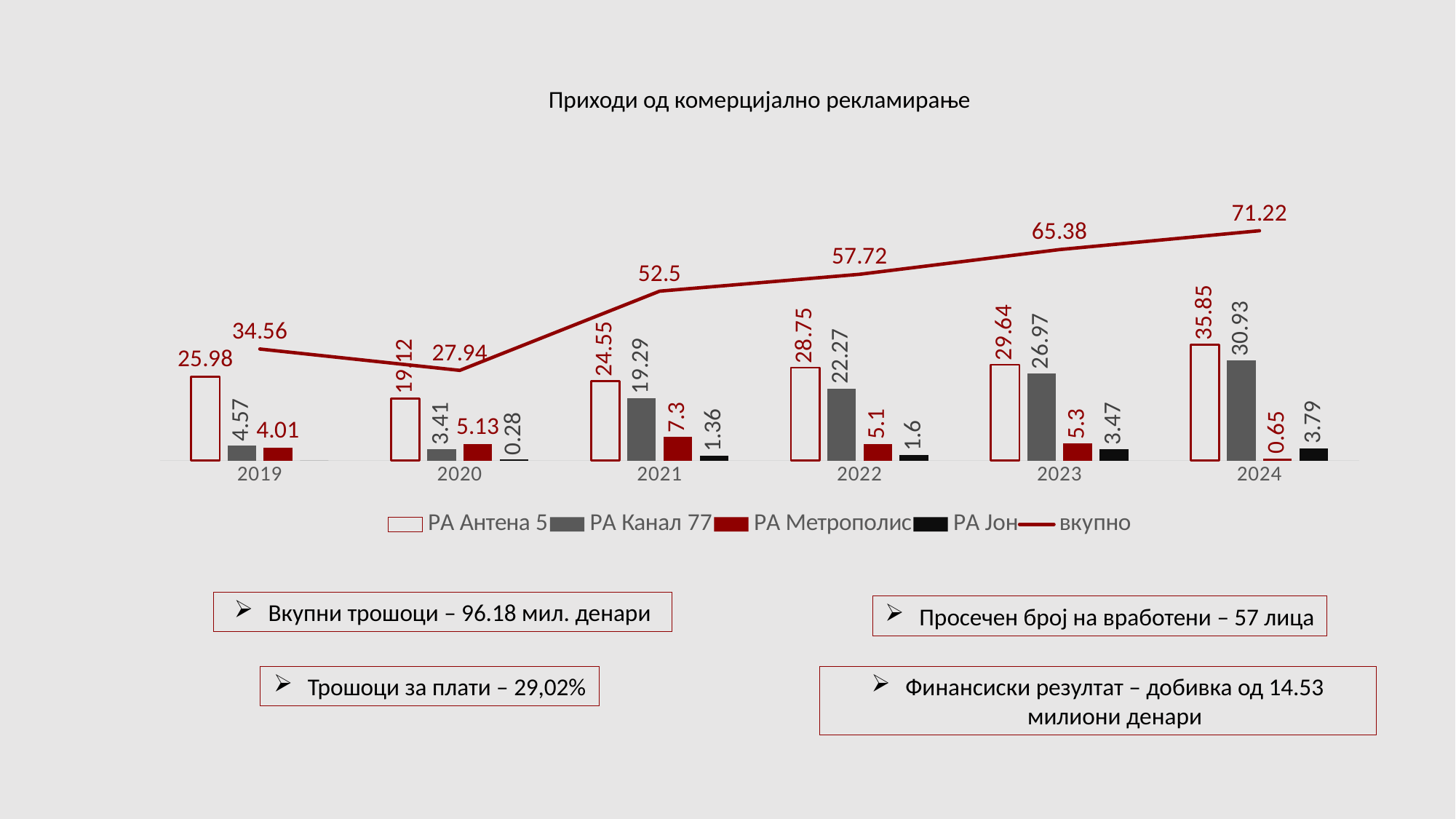
How many years are shown on the x axis? 6 What is the title of the chart? Приходи од комерцијално рекламирање Does the вкупно line rise or fall from 2020 to 2024? rise What is the value for РА Канал 77 in 2020? 3.41 How many series does the legend list? 5 What is the value of the вкупно line in 2021? 52.5 What is the value for РА Антена 5 in 2024? 35.85 Which is larger in 2021: РА Антена 5 or РА Канал 77? РА Антена 5 What is the difference between the вкупно values for 2024 and 2023? 5.84 What is the value for РА Метрополис in 2024? 0.65 In which year is the вкупно line at its lowest? 2020 In which year is the вкупно line at its highest? 2024